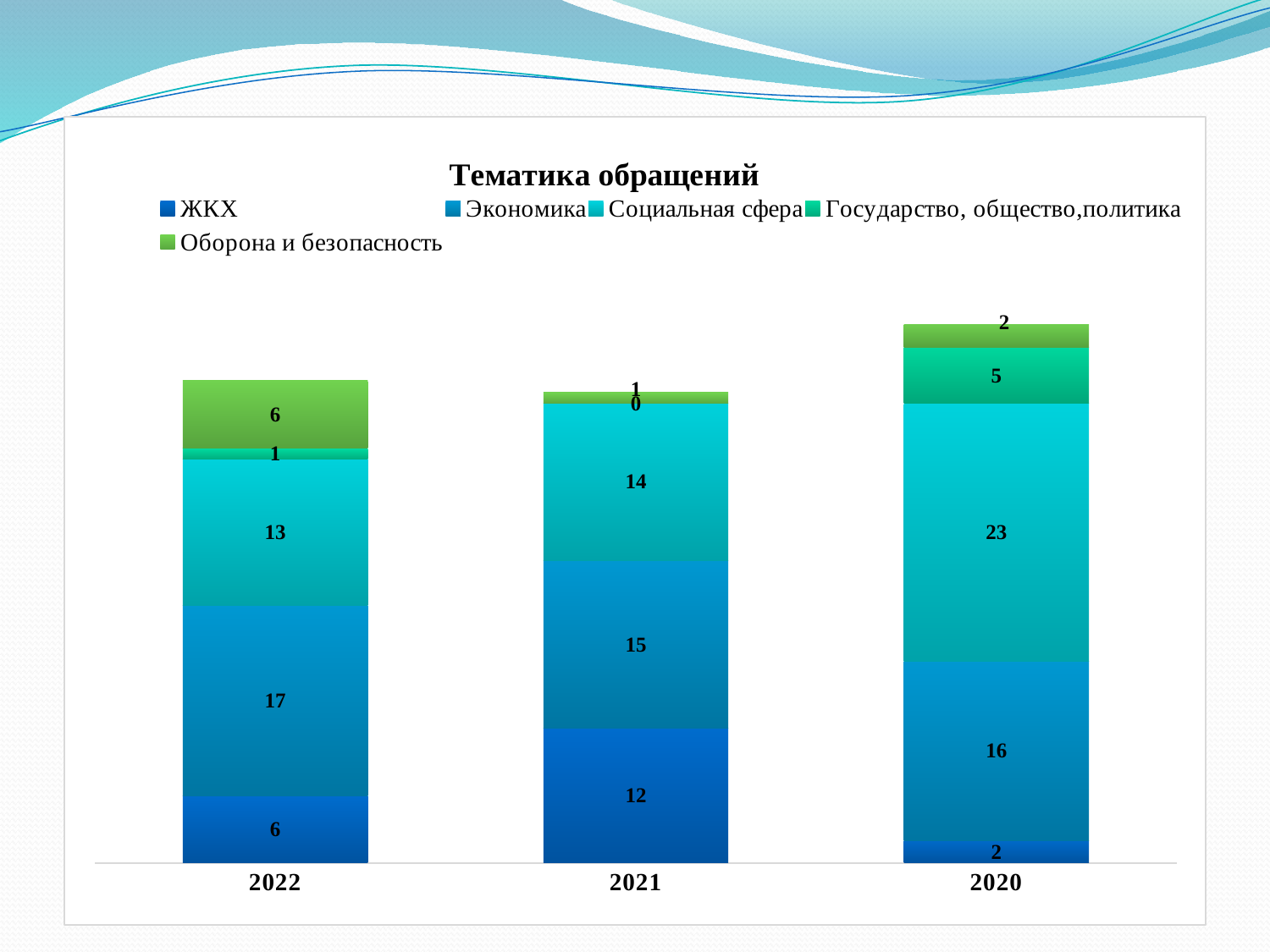
In which year is the value for ЖКХ the highest? 2021 What is the title of the chart? Тематика обращений How many series does the legend list? 5 What is the value for ЖКХ in 2021? 12 In which year is the value for Социальная сфера the lowest? 2022 How many categories (years) are shown on the x axis? 3 What is the total of the stacked bar for 2020? 48 What is the value for Социальная сфера in 2020? 23 What type of chart is shown on the slide? stacked bar chart What is the value for Экономика in 2022? 17 What is the difference between the Социальная сфера values for 2020 and 2021? 9 What is the value for Государство, общество,политика in 2021? 0